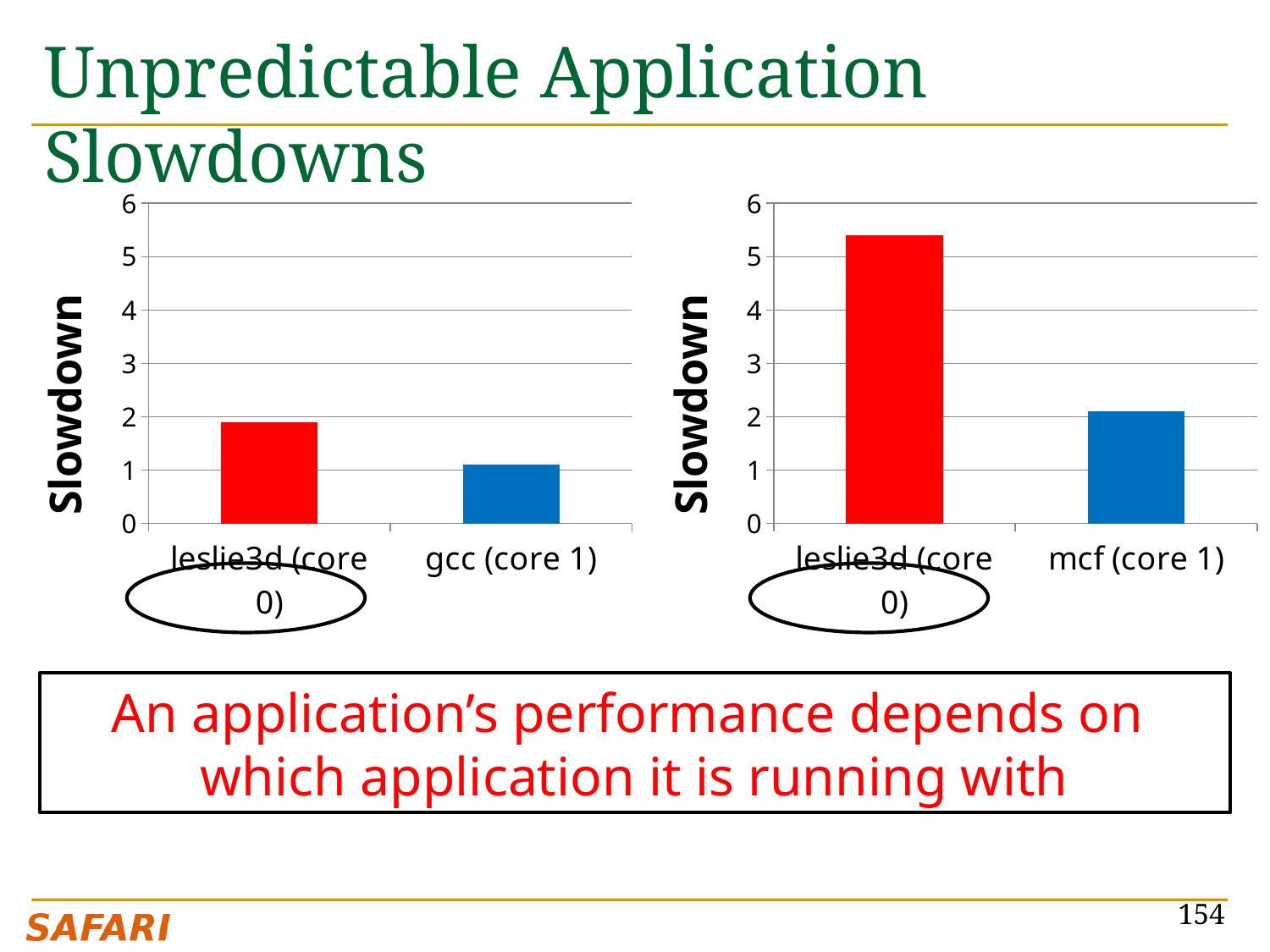
Is the slowdown of leslie3d (core 0) larger in the left chart or in the right chart? right chart In the left chart, is the slowdown for gcc (core 1) greater or less than 2? less What kind of chart is the left chart on the slide? bar chart In the right chart, which category has the lower slowdown? mcf (core 1) In the left chart, which category has the lower slowdown? gcc (core 1) In the left chart, is the slowdown for leslie3d (core 0) greater or less than 1? greater How many bars are shown in the left chart? 2 In the left chart, which category has the higher slowdown? leslie3d (core 0) In the right chart, is the slowdown for leslie3d (core 0) greater or less than 5? greater What is the y-axis label of the right chart? Slowdown In the right chart, which category has the higher slowdown? leslie3d (core 0)